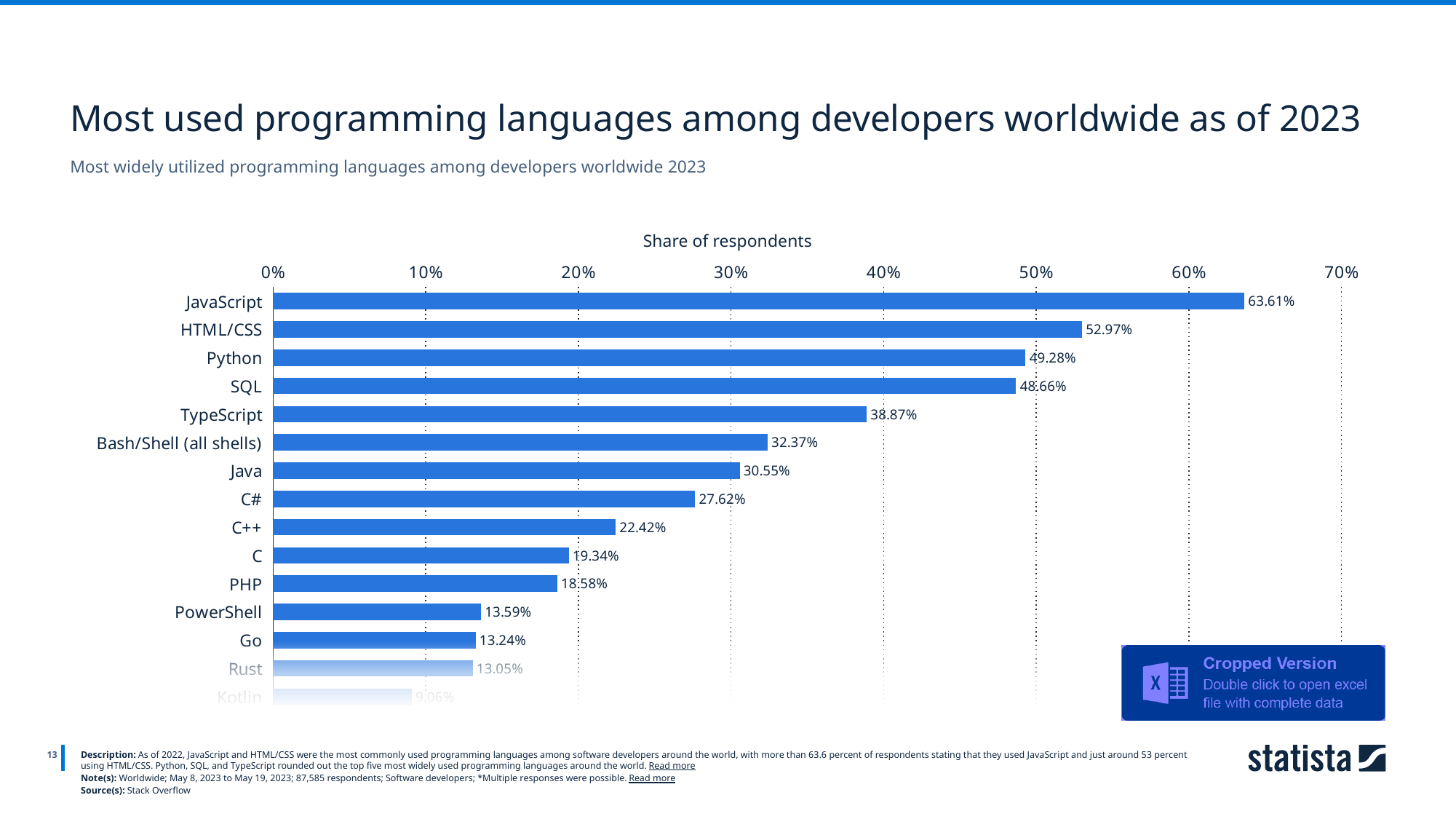
Which programming language has the highest share of respondents? JavaScript Is the value for SQL greater or less than 50%? less What is the difference between the shares for JavaScript and HTML/CSS? 10.64% What is the value shown for PHP? 18.58% Which has a larger share of respondents, TypeScript or Java? TypeScript Which has a larger share of respondents, C# or PowerShell? C# What is the value shown for Python? 49.28% What share of respondents is shown for Bash/Shell (all shells)? 32.37% What kind of chart is shown on the slide? bar chart What is the axis title shown above the chart? Share of respondents What is the difference between the values for C++ and C? 3.08% What share of respondents reported using JavaScript? 63.61%